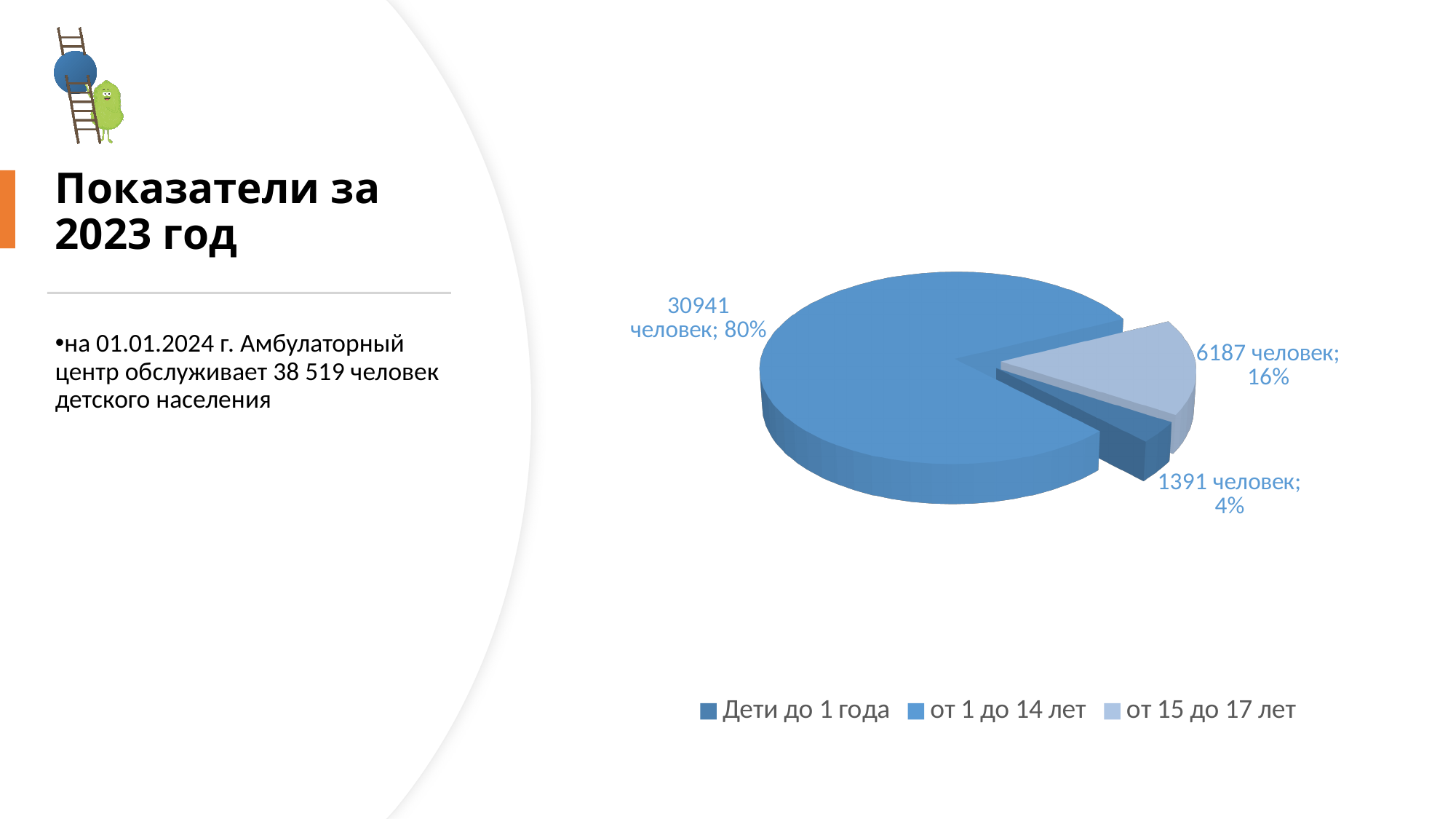
What is the value shown for the slice 'от 15 до 17 лет'? 6187 человек Which slice of the pie chart is the largest? от 1 до 14 лет What kind of chart is shown on the slide? pie chart How many slices does the pie chart have? 3 How many entries does the legend of the pie chart list? 3 Which slice of the pie chart is the smallest? Дети до 1 года What is the value shown for the slice 'от 1 до 14 лет'? 30941 человек Which is larger: the value for 'от 15 до 17 лет' or the value for 'Дети до 1 года'? от 15 до 17 лет What is the difference between the values for 'от 15 до 17 лет' and 'Дети до 1 года'? 4796 человек What is the value shown for the slice 'Дети до 1 года'? 1391 человек What share of the pie does the slice 'от 15 до 17 лет' represent? 16% What share of the pie does the slice 'Дети до 1 года' represent? 4%